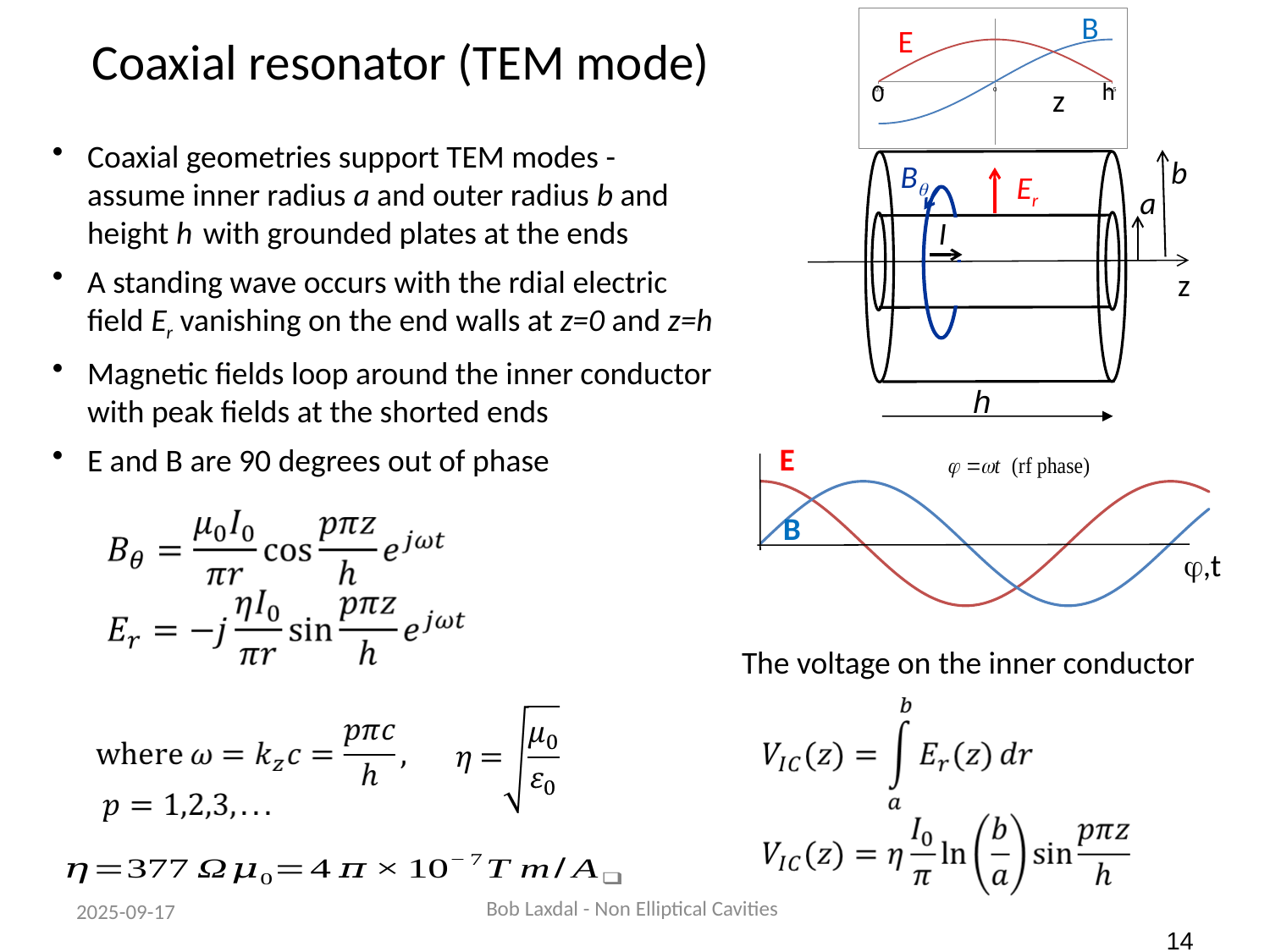
In the middle-right chart of E and B against rf phase, which curve is drawn in blue? B What kind of chart is the top-right chart showing E and B against z? line chart In the top-right chart of E and B against z, does the B curve rise or fall as z goes from 0 to h? rises In the top-right chart of E and B against z, where along the z axis does the E curve reach its maximum? at the middle of the z axis What is the label on the horizontal axis of the top-right chart of E and B? z In the top-right chart of E and B against z, which curve is larger at z=0, E or B? E In the middle-right chart of E and B against rf phase, which curve is larger at φ=0, E or B? E In the middle-right chart of E and B against rf phase, does the E curve rise or fall immediately after φ=0? falls What kind of chart is the middle-right chart showing E and B against rf phase (φ,t)? line chart How many series are plotted in the top-right chart of E and B against z? 2 In the middle-right chart of E and B against rf phase, does the B curve rise or fall immediately after φ=0? rises How many series are plotted in the middle-right chart of E and B against rf phase? 2